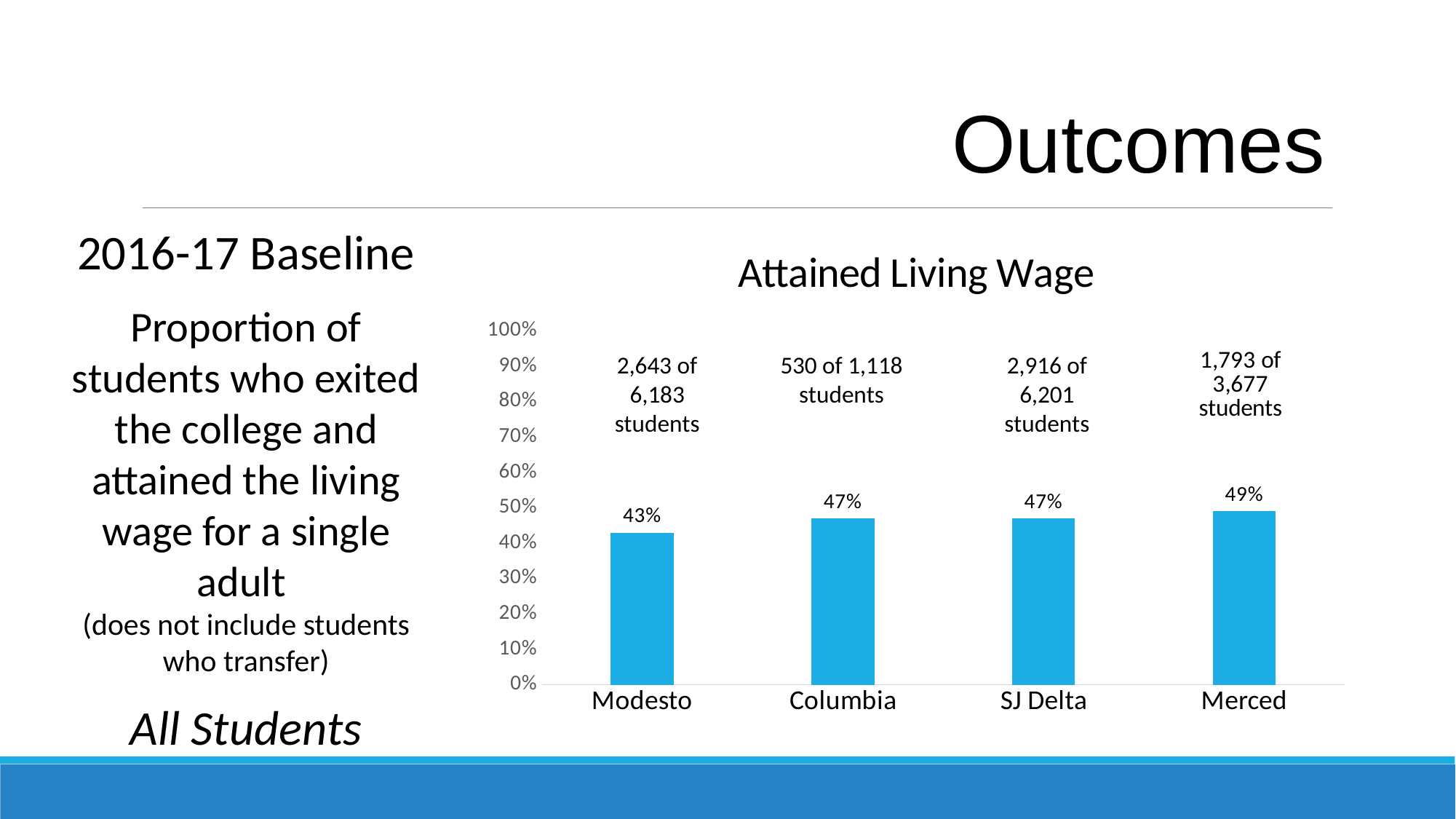
Which college has the highest value? Merced What is the title of the chart? Attained Living Wage Which is larger, the value for Modesto or the value for SJ Delta? SJ Delta What is the value for Modesto? 43% What is the value for Merced? 49% Is the value for Merced greater or less than 40%? greater Which college has the lowest value? Modesto What is the difference between the values for Merced and Modesto? 6% How many students does the annotation above the Columbia bar say attained the living wage? 530 of 1,118 students What is the value for Columbia? 47% What kind of chart is shown? bar chart How many colleges are shown on the chart? 4